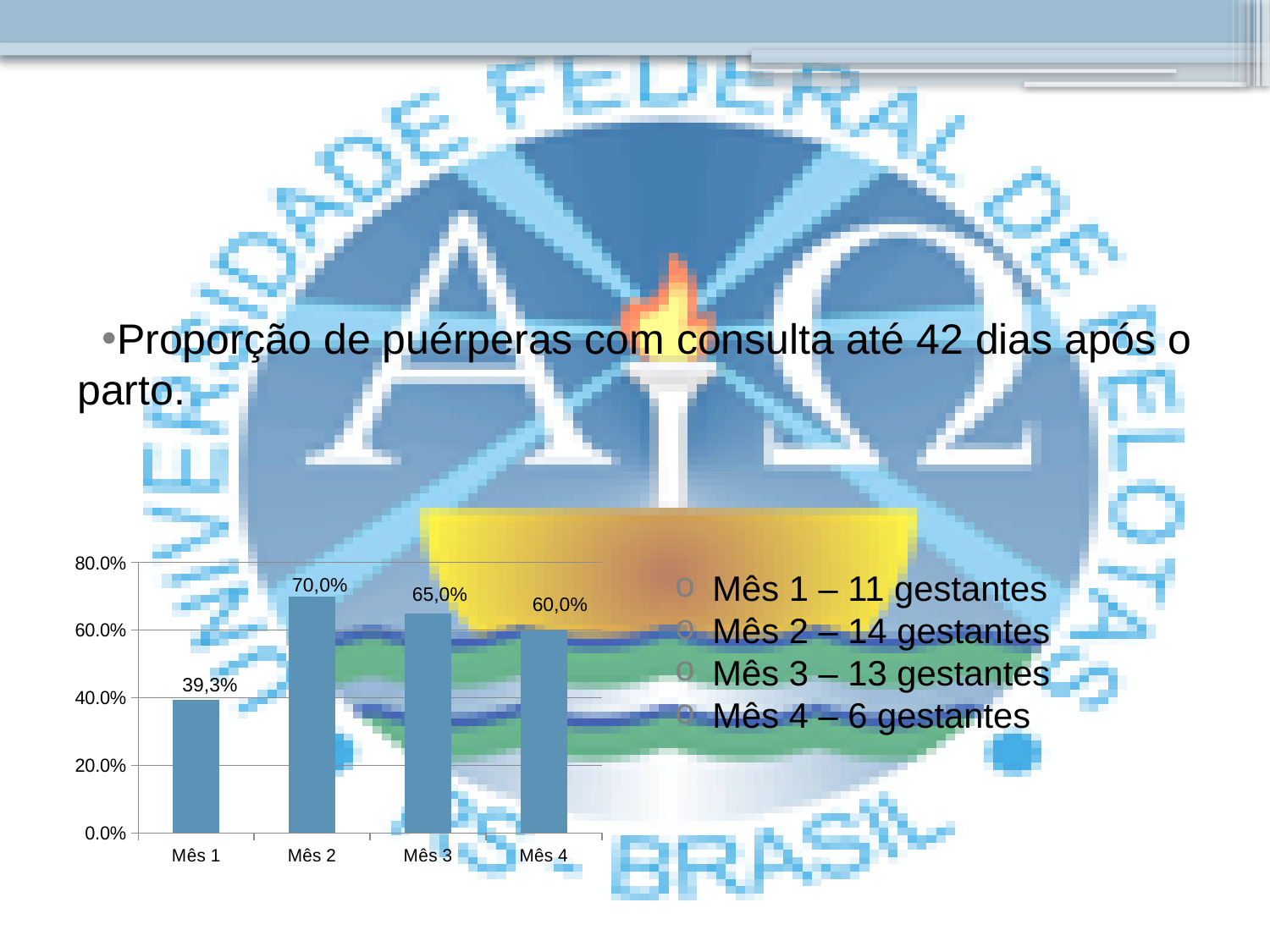
Which is larger, the value for Mês 3 or the value for Mês 4? Mês 3 What is the difference between the values for Mês 3 and Mês 4? 5,0% Which month has the lowest value? Mês 1 What is the value for Mês 4? 60,0% What is the value for Mês 3? 65,0% Which month has the highest value? Mês 2 What kind of chart is shown on the slide? Bar chart What is the value for Mês 1? 39,3% How many categories are shown on the x axis? 4 What is the value for Mês 2? 70,0% Do the values rise or fall from Mês 2 to Mês 4? Fall What is the difference between the values for Mês 2 and Mês 1? 30,7%